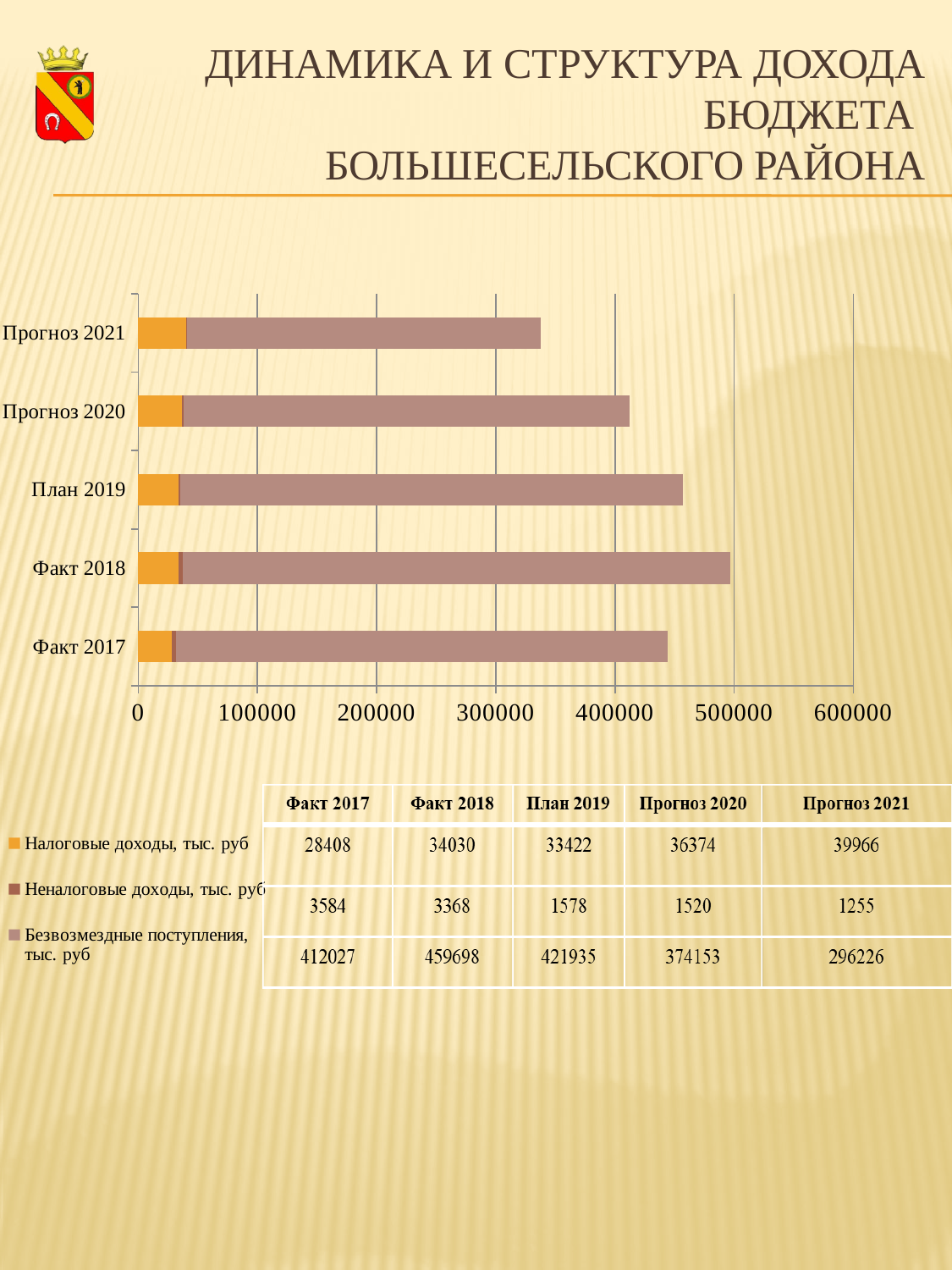
What is the value of Налоговые доходы for Факт 2017? 28408 What is the difference between Налоговые доходы for Прогноз 2021 and Факт 2017? 11558 Is the total bar for Прогноз 2021 greater or less than 400000? less Which category has the highest value of Безвозмездные поступления? Факт 2018 What is the value of Безвозмездные поступления for Прогноз 2021? 296226 What is the value of Неналоговые доходы for План 2019? 1578 Which is larger: Безвозмездные поступления for План 2019 or for Прогноз 2020? План 2019 What is the total of the stacked bar for Факт 2018? 497096 Which category has the lowest value of Неналоговые доходы? Прогноз 2021 What type of chart is shown on the slide? Stacked bar chart How many series does the legend list? 3 How many categories are plotted on the chart? 5